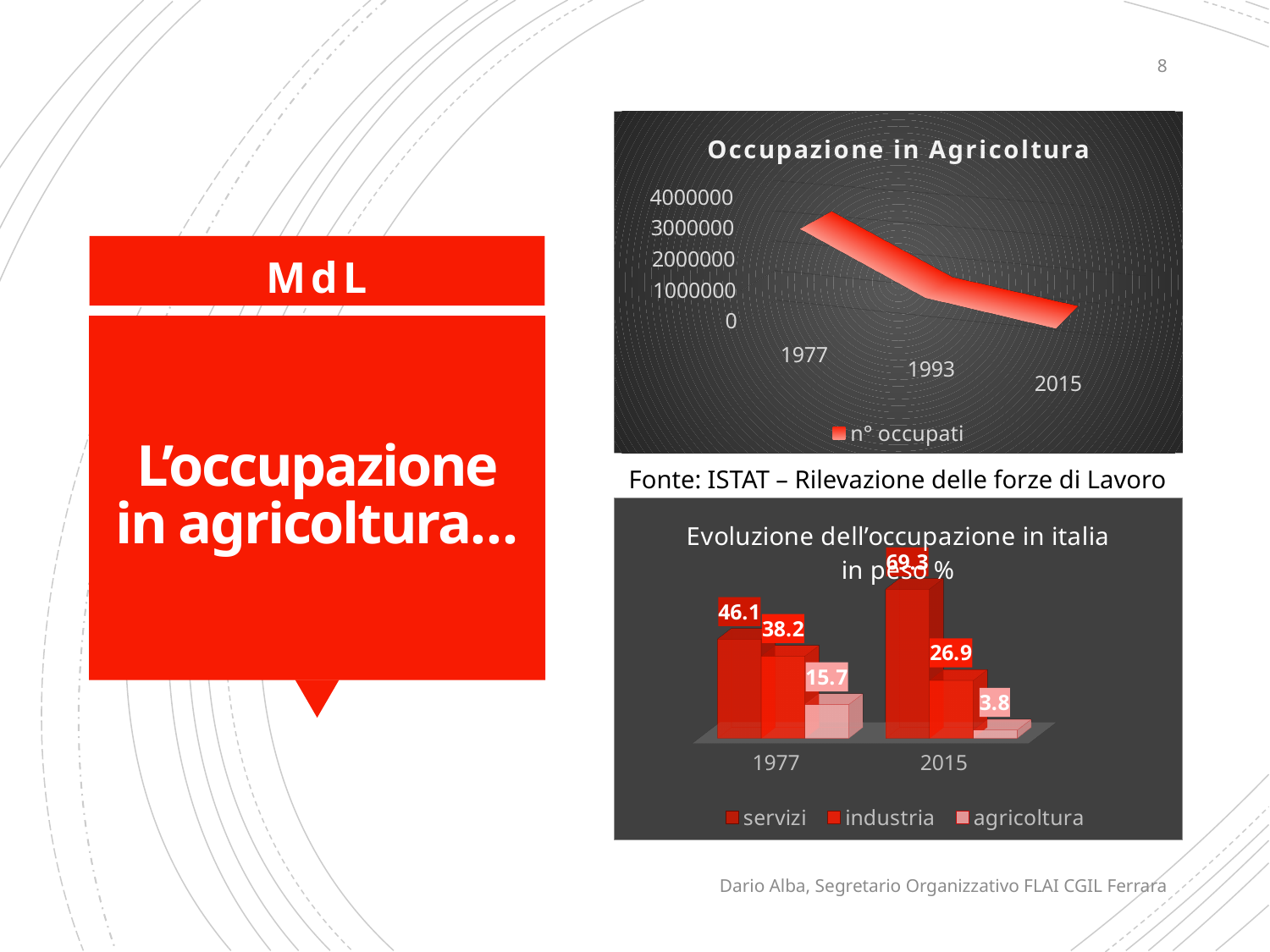
In the top chart 'Occupazione in Agricoltura', is the value for 1977 greater or less than 2000000? greater In the top chart 'Occupazione in Agricoltura', how many years are shown on the x axis? 3 In the bottom chart 'Evoluzione dell'occupazione in italia in peso %', what is the difference between the industria values for 1977 and 2015? 11.3 What kind of chart is the bottom chart 'Evoluzione dell'occupazione in italia in peso %'? bar chart What kind of chart is the top chart titled 'Occupazione in Agricoltura'? line chart In the bottom chart 'Evoluzione dell'occupazione in italia in peso %', what is the value for servizi in 2015? 69.3 In the bottom chart 'Evoluzione dell'occupazione in italia in peso %', what is the value for agricoltura in 1977? 15.7 In the bottom chart 'Evoluzione dell'occupazione in italia in peso %', which series has the lowest value in 2015? agricoltura In the top chart 'Occupazione in Agricoltura', is the value for 2015 greater or less than 1000000? less In the top chart 'Occupazione in Agricoltura', what is the legend entry? n° occupati In the top chart 'Occupazione in Agricoltura', do the values rise or fall from 1977 to 2015? fall In the bottom chart 'Evoluzione dell'occupazione in italia in peso %', how many series does the legend list? 3